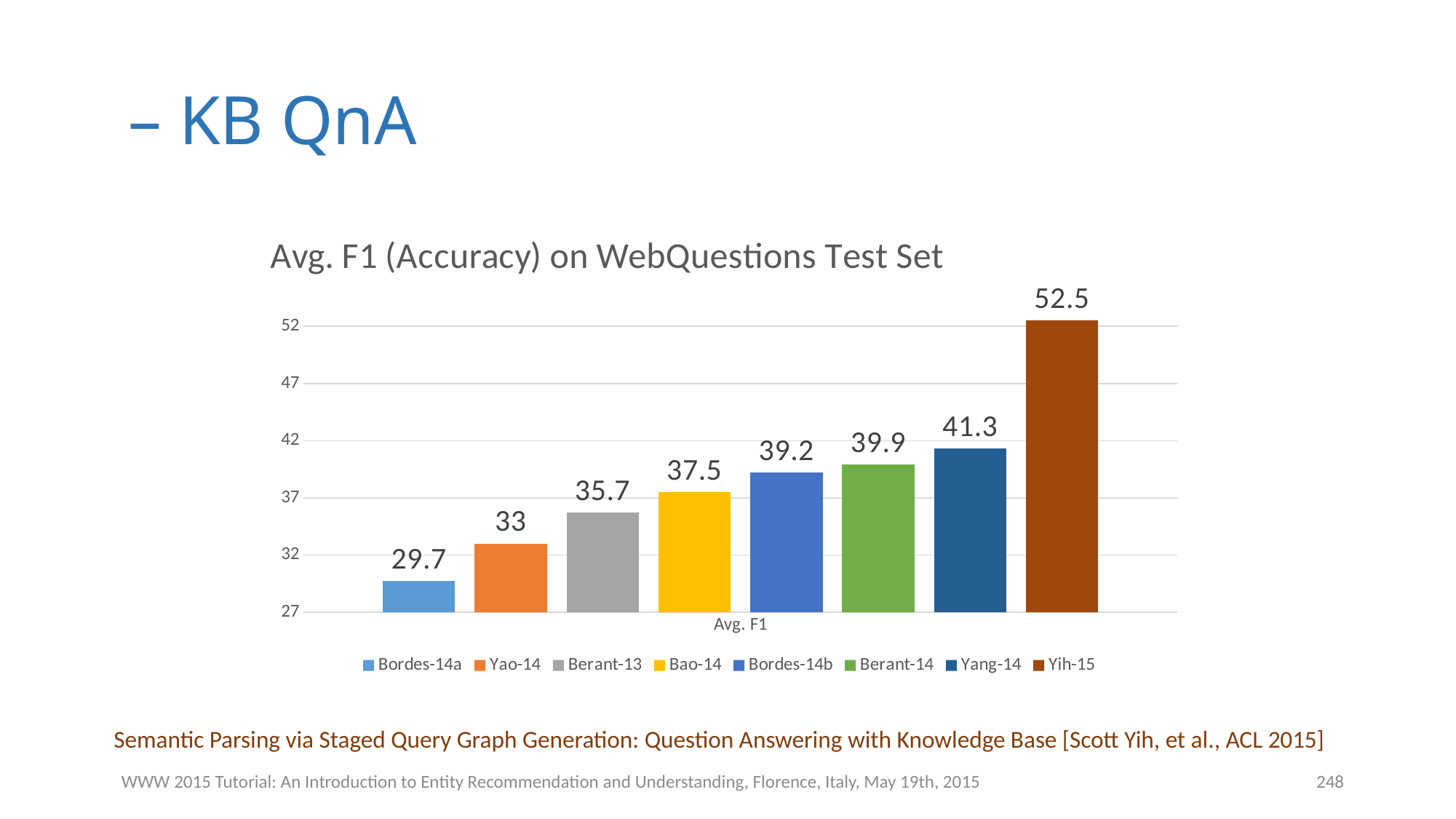
Is the value for Yang-14 greater or less than 42? less What is the Avg. F1 value for Yih-15? 52.5 What is the Avg. F1 value for Bao-14? 37.5 How many systems are shown in the chart? 8 Which system has the lowest Avg. F1? Bordes-14a What kind of chart is shown on the slide? bar chart What is the difference in Avg. F1 between Yih-15 and Yang-14? 11.2 Which system has the highest Avg. F1? Yih-15 Which has a higher Avg. F1, Berant-13 or Bordes-14b? Bordes-14b What is the Avg. F1 value for Bordes-14a? 29.7 What is the difference in Avg. F1 between Yao-14 and Bordes-14a? 3.3 What is the title of the chart? Avg. F1 (Accuracy) on WebQuestions Test Set